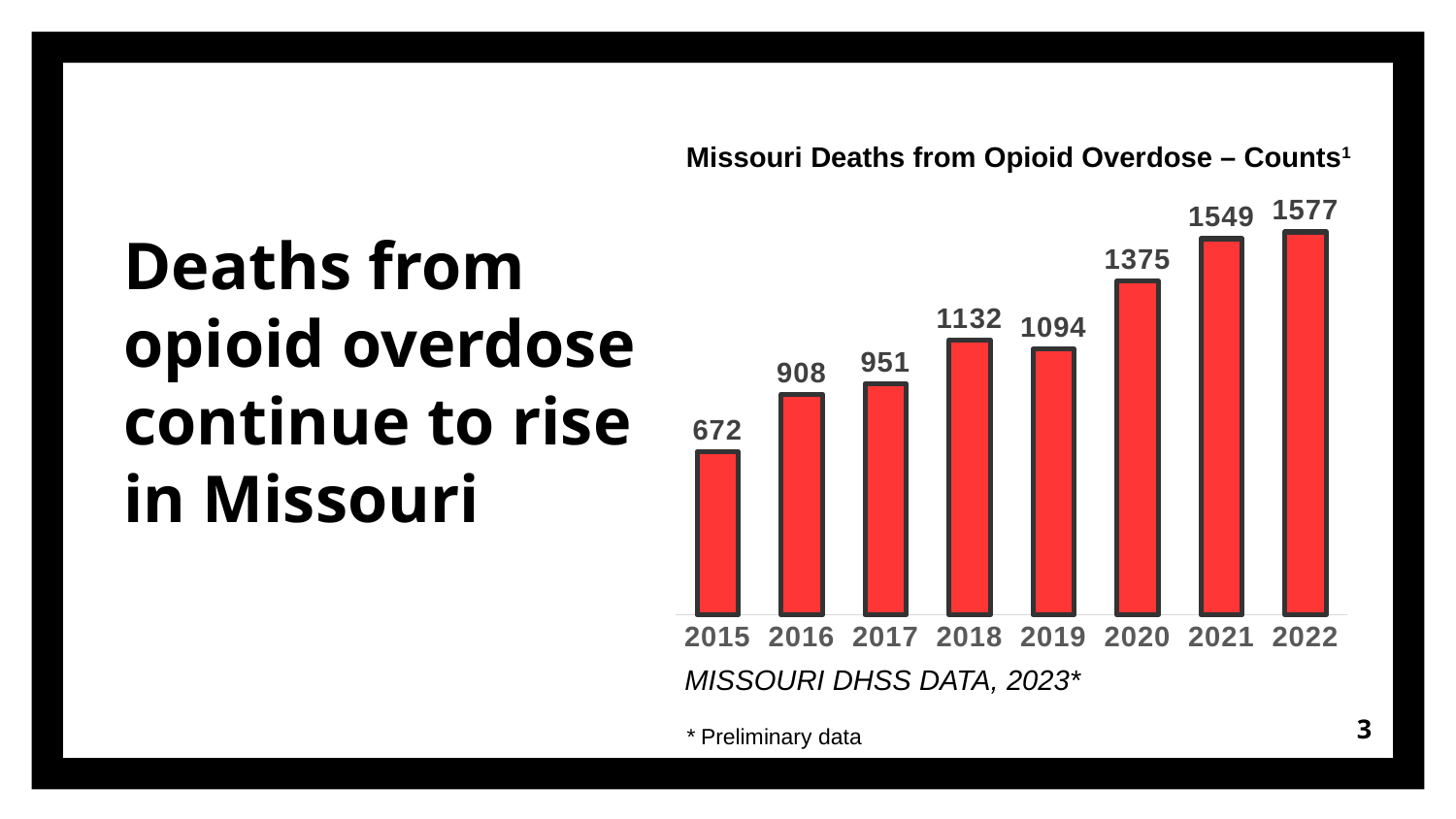
What is the number of Missouri deaths from opioid overdose in 2022? 1577 What is the difference in opioid overdose deaths between 2018 and 2019? 38 Do opioid overdose deaths generally rise or fall from 2015 to 2022? Rise How many years are shown on the chart? 8 Which year has the lowest count of opioid overdose deaths? 2015 Which year has the highest count of opioid overdose deaths? 2022 What is the number of Missouri deaths from opioid overdose in 2019? 1094 Which year had more opioid overdose deaths, 2018 or 2019? 2018 What is the title of the chart? Missouri Deaths from Opioid Overdose – Counts What kind of chart is shown on the slide? Bar chart What is the difference in opioid overdose deaths between 2022 and 2015? 905 What is the number of Missouri deaths from opioid overdose in 2015? 672